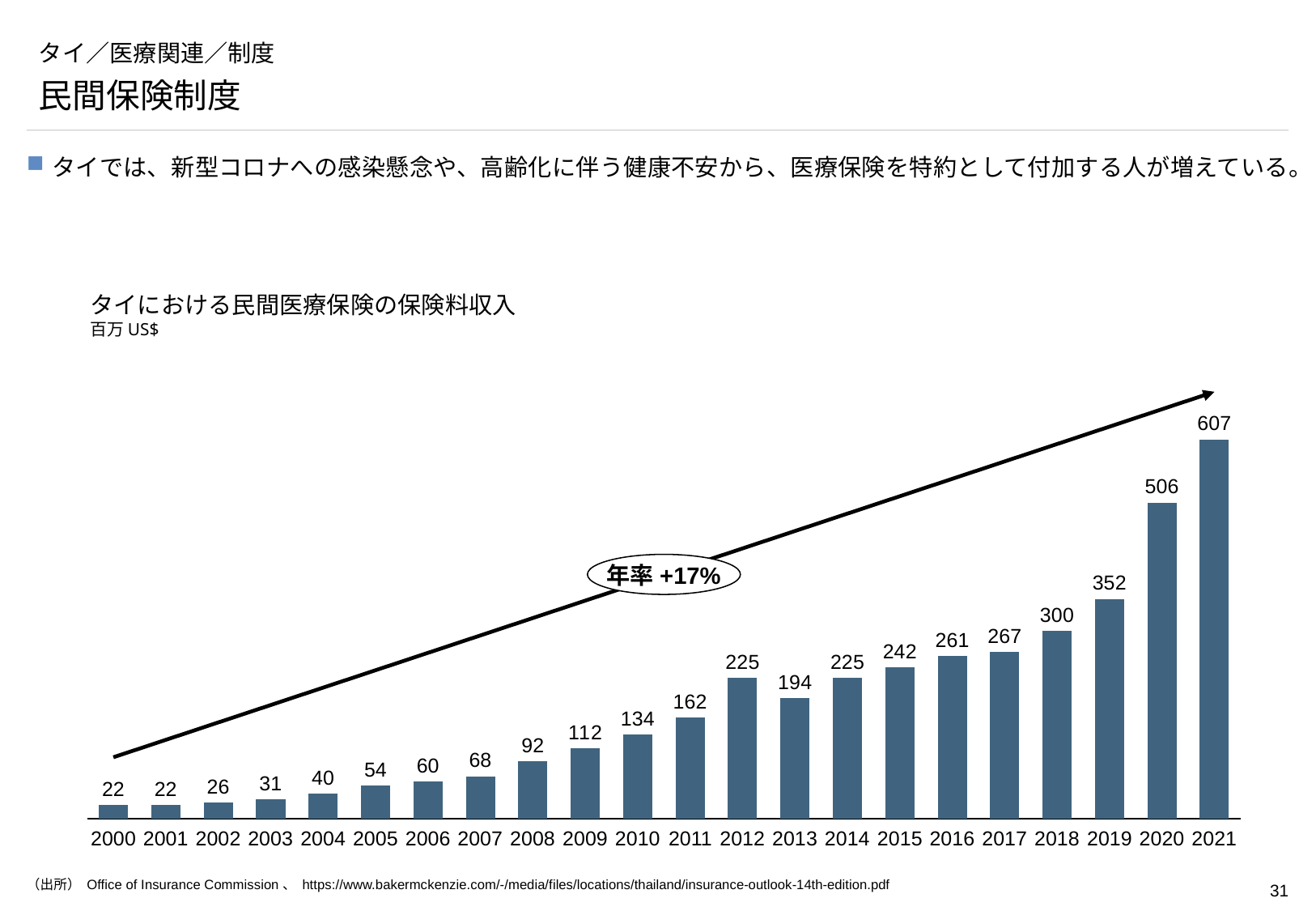
Which year has the lowest value? 2000 and 2001 What annual growth rate is shown in the label on the arrow? 年率 +17% How many years are shown on the x axis? 22 What is the difference between the values for 2021 and 2020? 101 Do the values generally rise or fall from 2000 to 2021? rise What unit is stated under the chart title? 百万 US$ Which year has the highest value? 2021 What kind of chart is this? bar chart What is the value for 2012? 225 What is the value for 2000? 22 What is the value for 2021? 607 Which is larger, the value for 2013 or the value for 2014? 2014